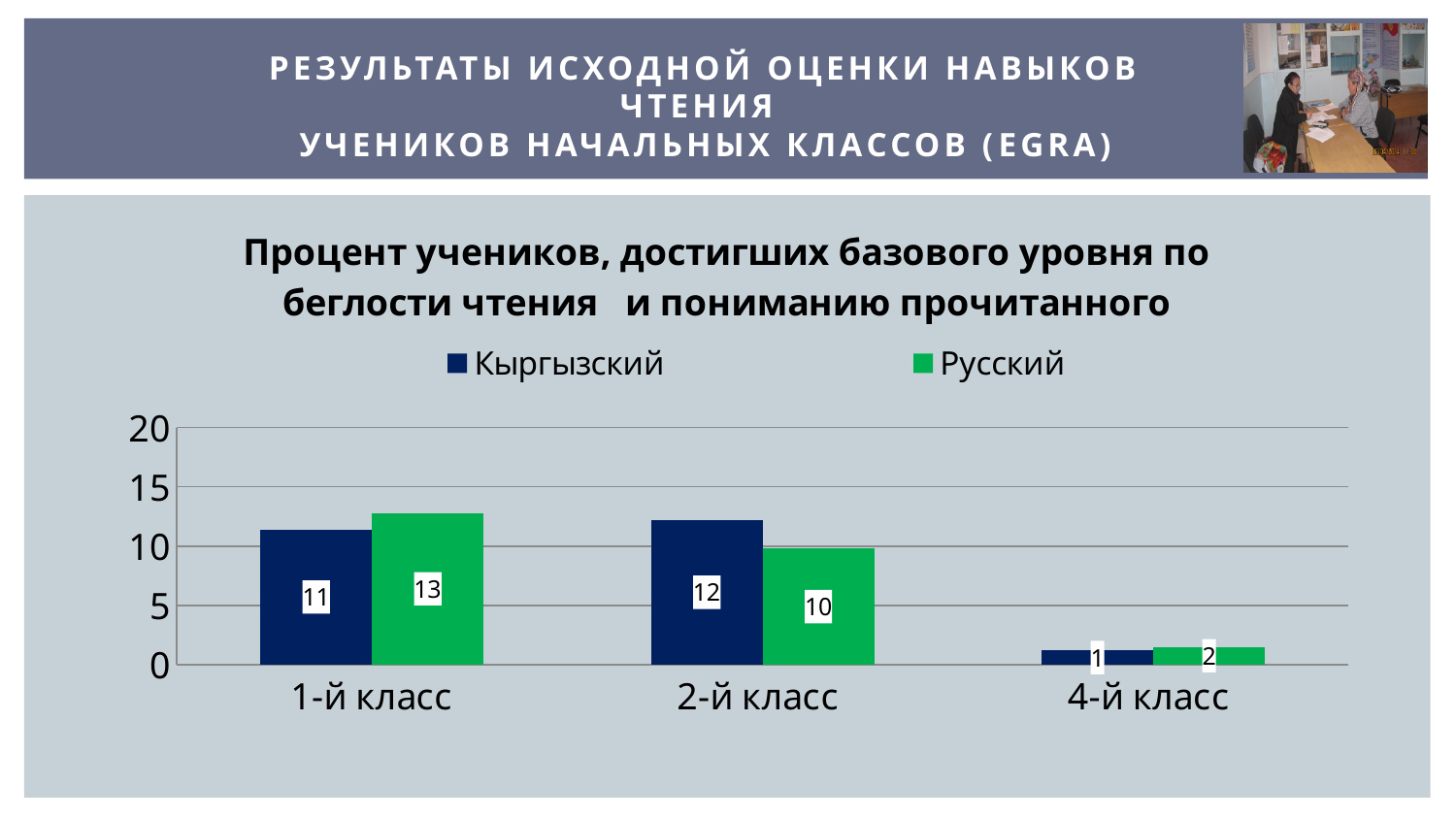
What is the value for Русский in 2-й класс? 10 In 2-й класс, which series has the larger value, Кыргызский or Русский? Кыргызский Which colour represents the Русский series? green What is the difference between the Русский and Кыргызский values in 1-й класс? 2 What kind of chart is shown on the slide? bar chart What is the value for Русский in 4-й класс? 2 What is the value for Кыргызский in 1-й класс? 11 How many series does the legend list? 2 How many categories are shown on the x axis? 3 Which category has the highest value for Русский? 1-й класс Is the value for Русский in 1-й класс greater or less than 10? greater Which category has the lowest value for Кыргызский? 4-й класс